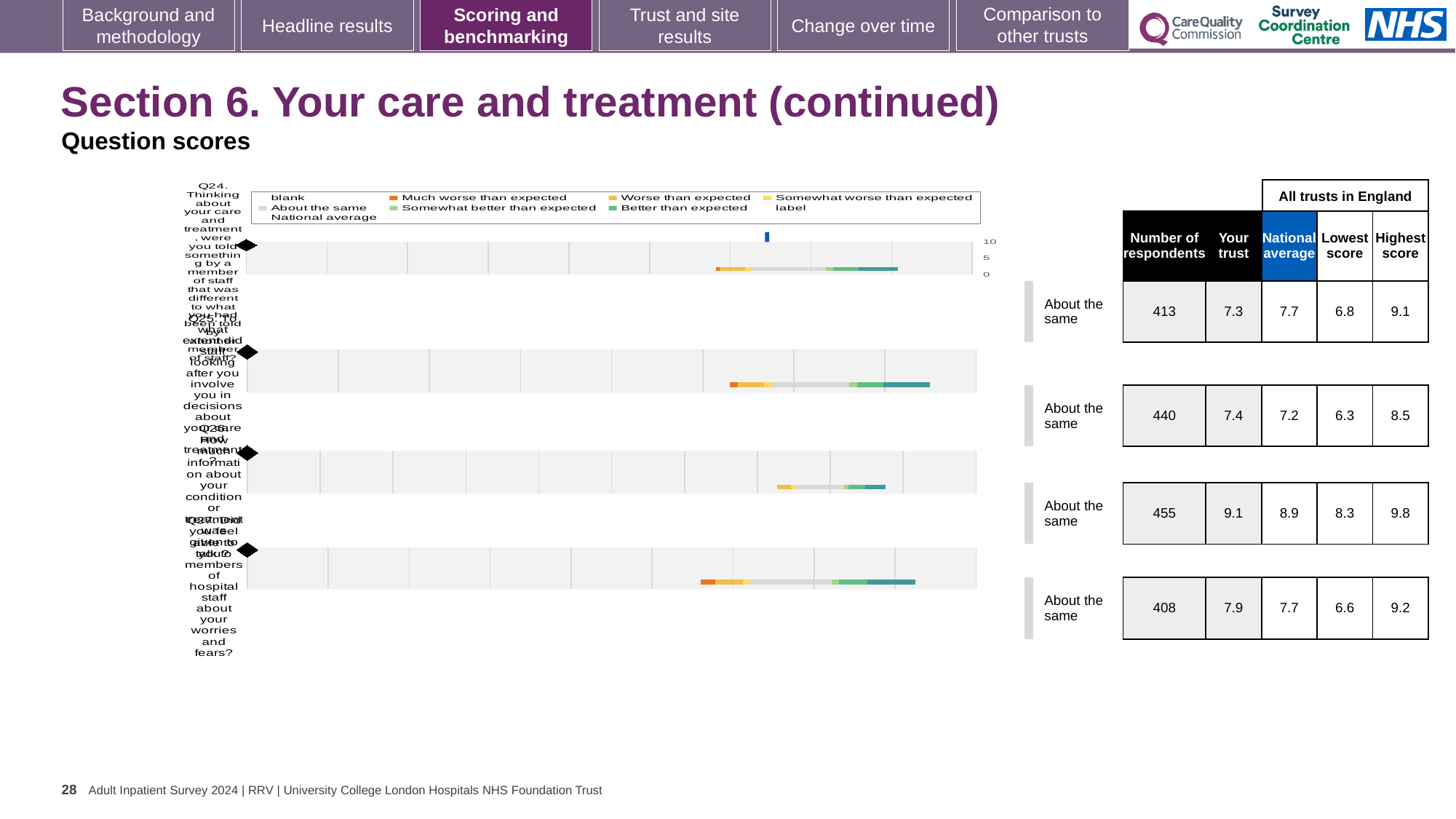
Which legend entry is shown in grey? About the same What is the 'Your trust' score for the first row (Q24)? 7.3 For the first row (Q24), which is larger: the 'Your trust' score or the national average? National average What is the highest score across all trusts in England for the fourth row (Q27)? 9.2 What is the difference between the national average and the 'Your trust' score for the first row (Q24)? 0.4 How many question rows (charts) are shown on the slide? 4 What is the national average for the first row (Q24)? 7.7 Which row has the lowest number of respondents? Q27 (fourth row), 408 Which row has the highest 'Your trust' score? Q26 (third row), 9.1 Which legend entry is shown in orange? Much worse than expected What is the number of respondents for the third row (Q26)? 455 What kind of chart is used for the four question rows on the left of the slide? bar chart